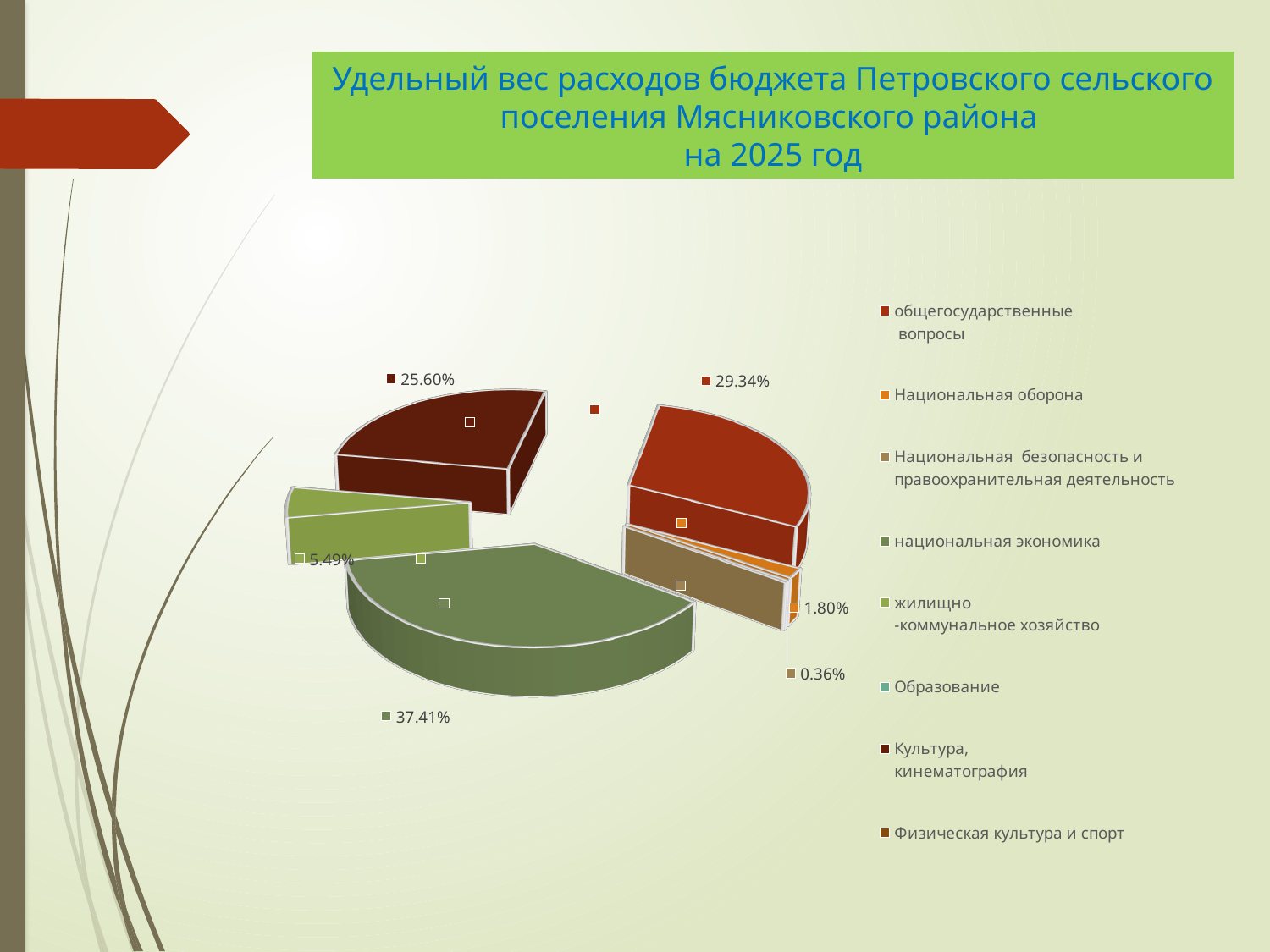
What year does the chart title refer to? 2025 What share is labelled for Национальная оборона? 1.80% What kind of chart is shown on the slide? pie chart What is the difference between the share for национальная экономика and the share for общегосударственные вопросы? 8.07% What share is labelled for общегосударственные вопросы? 29.34% What share is labelled for Культура, кинематография? 25.60% What share is labelled for жилищно-коммунальное хозяйство? 5.49% What share of the budget expenditures is labelled for национальная экономика? 37.41% Which category has the largest share of the pie? национальная экономика Which is larger, the share for общегосударственные вопросы or the share for Культура, кинематография? общегосударственные вопросы What share is labelled for Национальная безопасность и правоохранительная деятельность? 0.36% How many entries does the legend list? 8